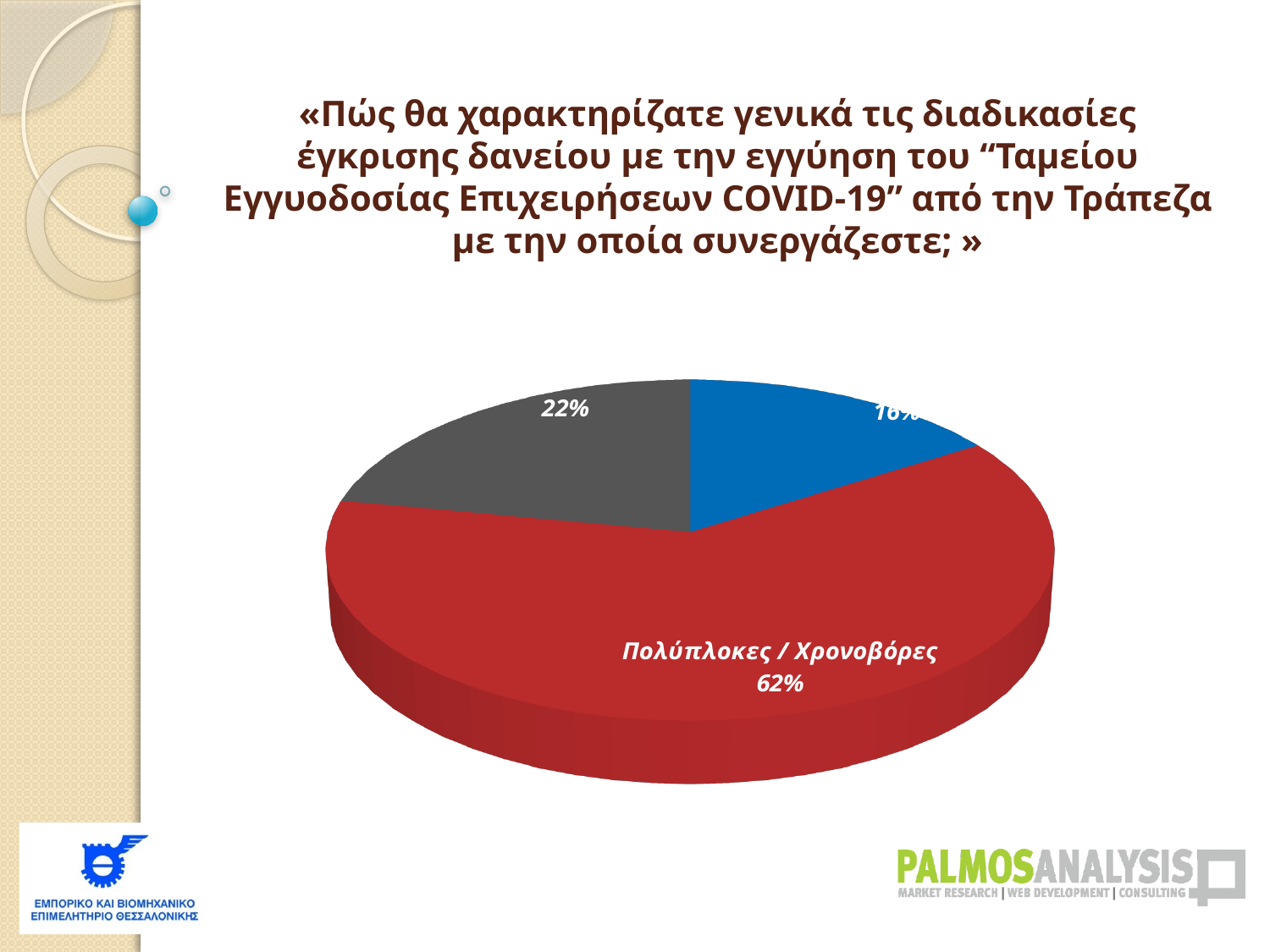
Is the share for "Πολύπλοκες / Χρονοβόρες" greater or less than 50%? greater What is the difference in percentage points between the red slice (Πολύπλοκες / Χρονοβόρες) and the grey slice? 40% What colour is the largest slice of the pie chart? red Which colour slice is the smallest in the pie chart? blue How many slices does the pie chart have? 3 Which is larger, the grey slice or the blue slice? the grey slice What percentage is shown on the grey slice of the pie chart? 22% What kind of chart is shown on the slide? pie chart Which slice of the pie chart is the largest? Πολύπλοκες / Χρονοβόρες What share of the pie does the "Πολύπλοκες / Χρονοβόρες" slice represent? 62% What percentage is shown for the slice labelled "Πολύπλοκες / Χρονοβόρες"? 62%